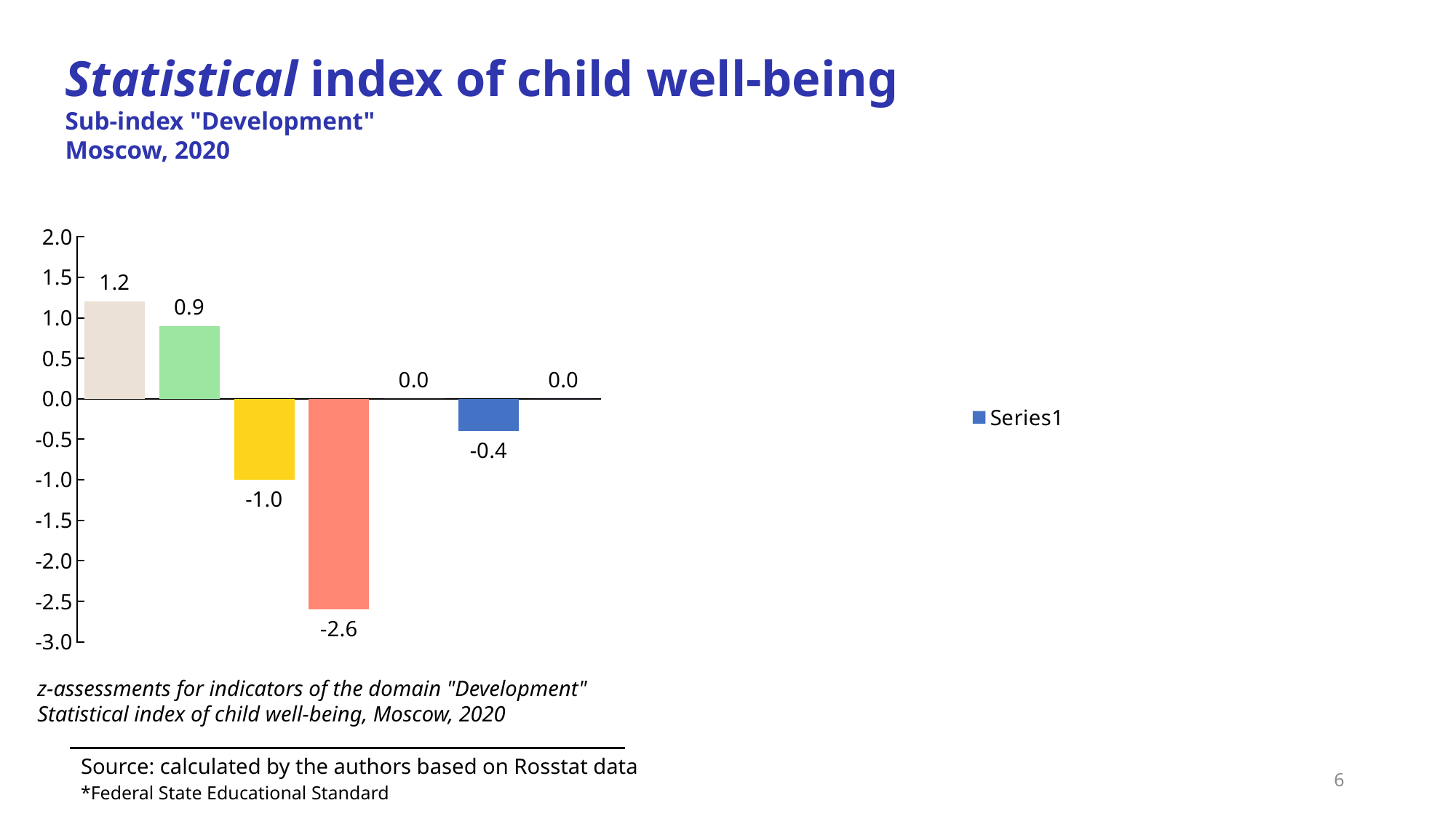
What is the highest value shown in the chart? 1.2 What is the value of the blue bar? -0.4 What is the value of the first (leftmost) bar? 1.2 What is the lowest value shown in the chart? -2.6 What is the value of the yellow bar? -1.0 How many series does the legend list? 1 Which is larger, the value of the yellow bar or the value of the blue bar? the blue bar (-0.4) What is the difference between the first bar (1.2) and the second bar (0.9)? 0.3 What is the value of the green bar? 0.9 How many bars (data points) are plotted in the chart? 7 What is the legend entry shown on the slide? Series1 What kind of chart is shown on the slide? bar chart